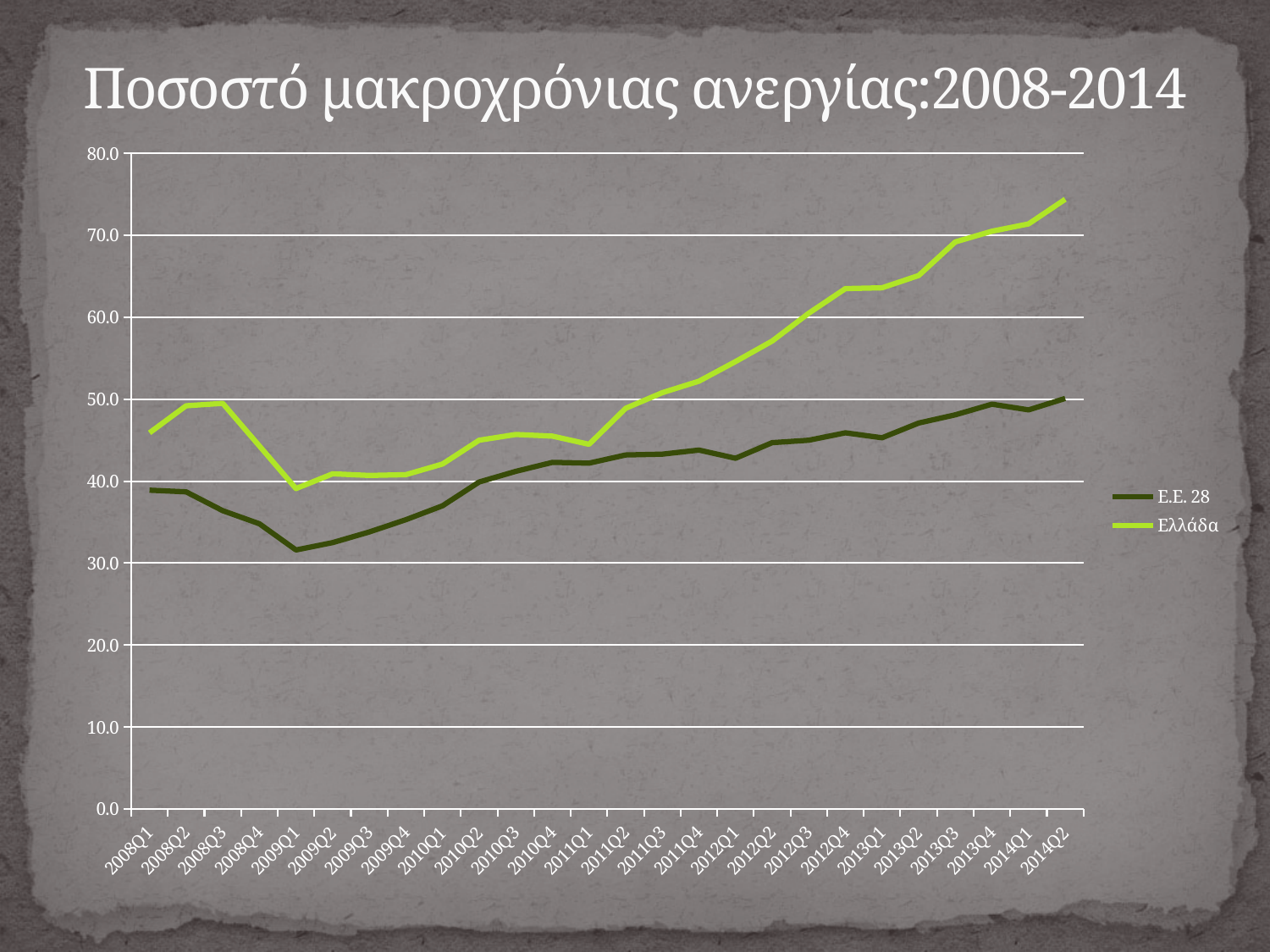
Does the Ελλάδα series rise or fall from 2011Q1 to 2014Q2? rise Is the value for Ελλάδα in 2014Q2 greater or less than 70? greater What is the title of the chart? Ποσοστό μακροχρόνιας ανεργίας:2008-2014 Which two series are listed in the legend? Ε.Ε. 28 and Ελλάδα In which quarter does the Ελλάδα series reach its lowest value? 2009Q1 Which series has the larger value in 2013Q3, Ε.Ε. 28 or Ελλάδα? Ελλάδα What kind of chart is shown on the slide? line chart How many quarters are plotted along the x axis? 26 How many series does the legend list? 2 In which quarter does the Ελλάδα series reach its highest value? 2014Q2 In which quarter does the Ε.Ε. 28 series reach its lowest value? 2009Q1 Is the value for Ε.Ε. 28 in 2008Q4 greater or less than 40? less